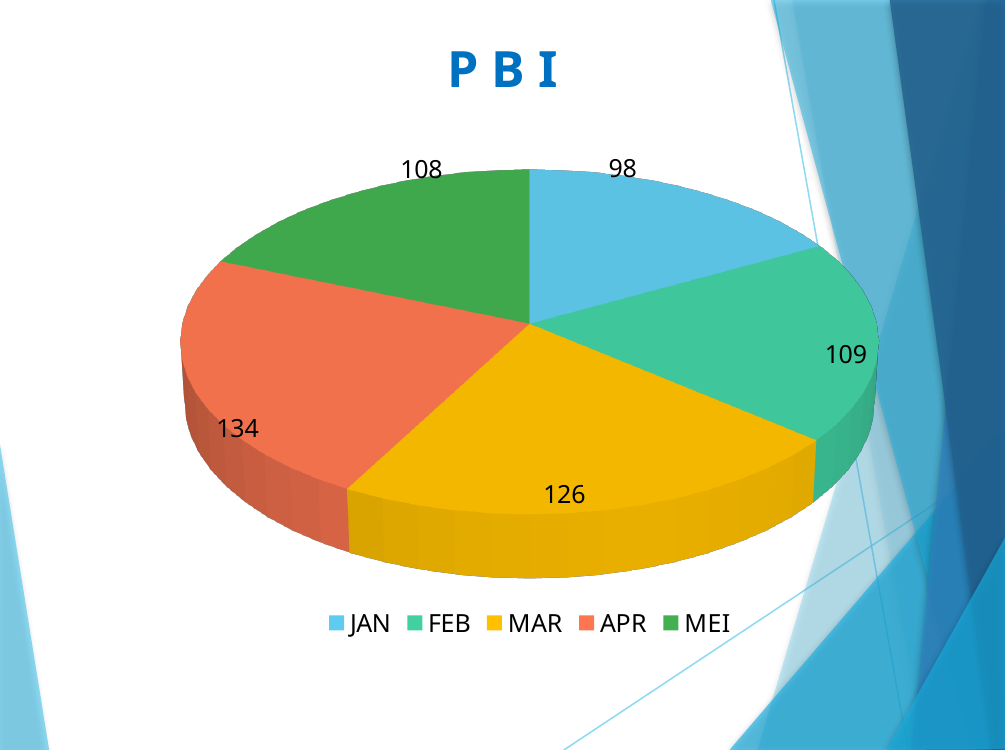
What is the value for JAN? 98 Which is larger, the value for FEB or the value for MEI? FEB What is the title of the chart? P B I What colour is the MAR slice? Yellow Which category has the largest slice? APR What is the difference between the values for MAR and FEB? 17 What is the difference between the values for APR and JAN? 36 What kind of chart is shown on the slide? Pie chart What is the value for APR? 134 How many slices does the pie chart have? 5 What is the value for MEI? 108 Which category has the smallest slice? JAN